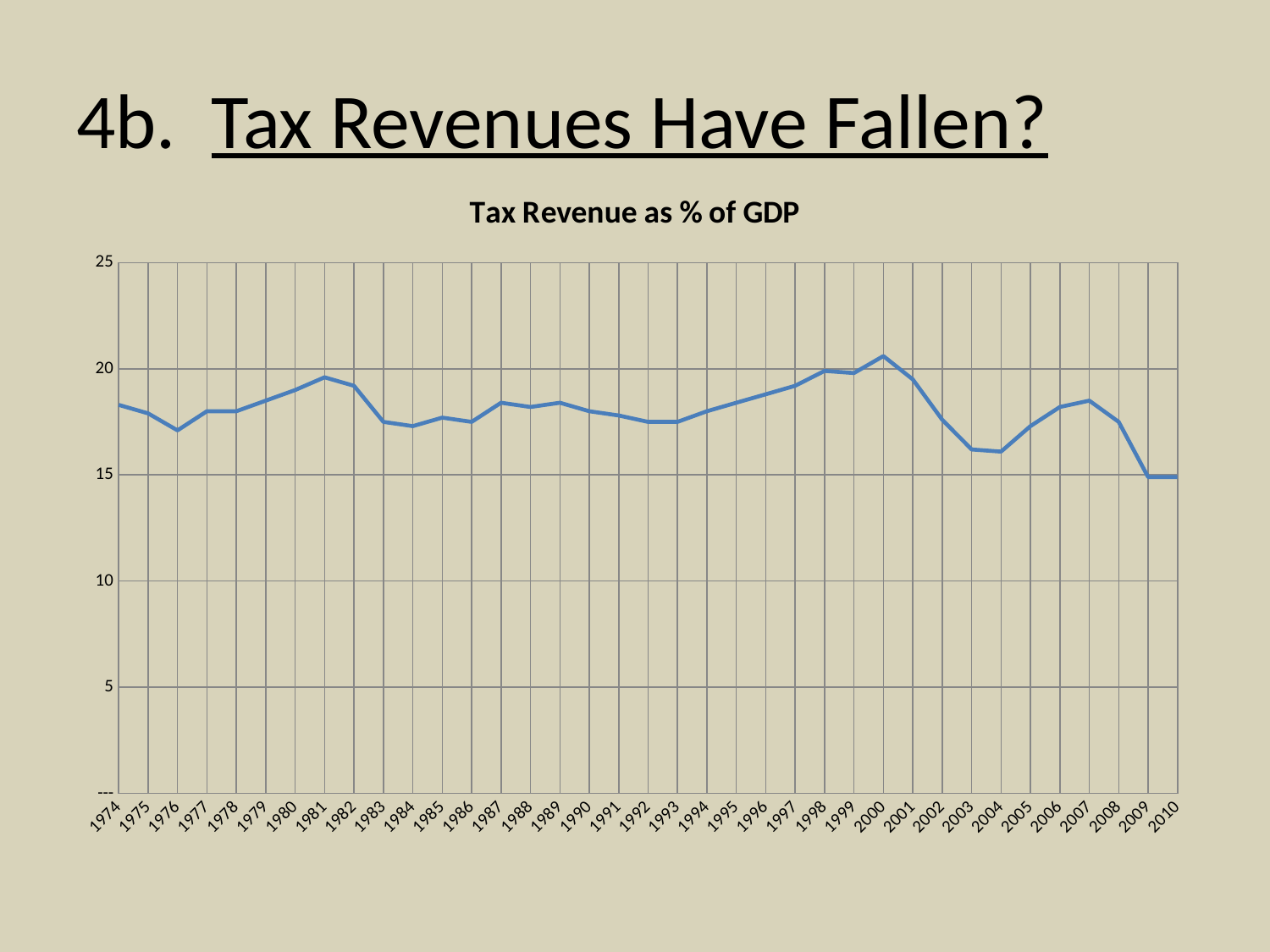
Which year has the higher value, 2000 or 2003? 2000 Is the value for 1981 greater or less than 20? less Is the value for 1976 greater or less than 15? greater Is the value for 2003 greater or less than 20? less How many years are plotted along the x axis of the chart? 37 In which year does tax revenue as % of GDP reach its highest point? 2000 Does tax revenue as % of GDP rise or fall between 2007 and 2009? fall What is the title of the chart? Tax Revenue as % of GDP Does tax revenue as % of GDP rise or fall between 1993 and 2000? rise What kind of chart is shown on the slide? line chart Which year has the higher value, 1981 or 1976? 1981